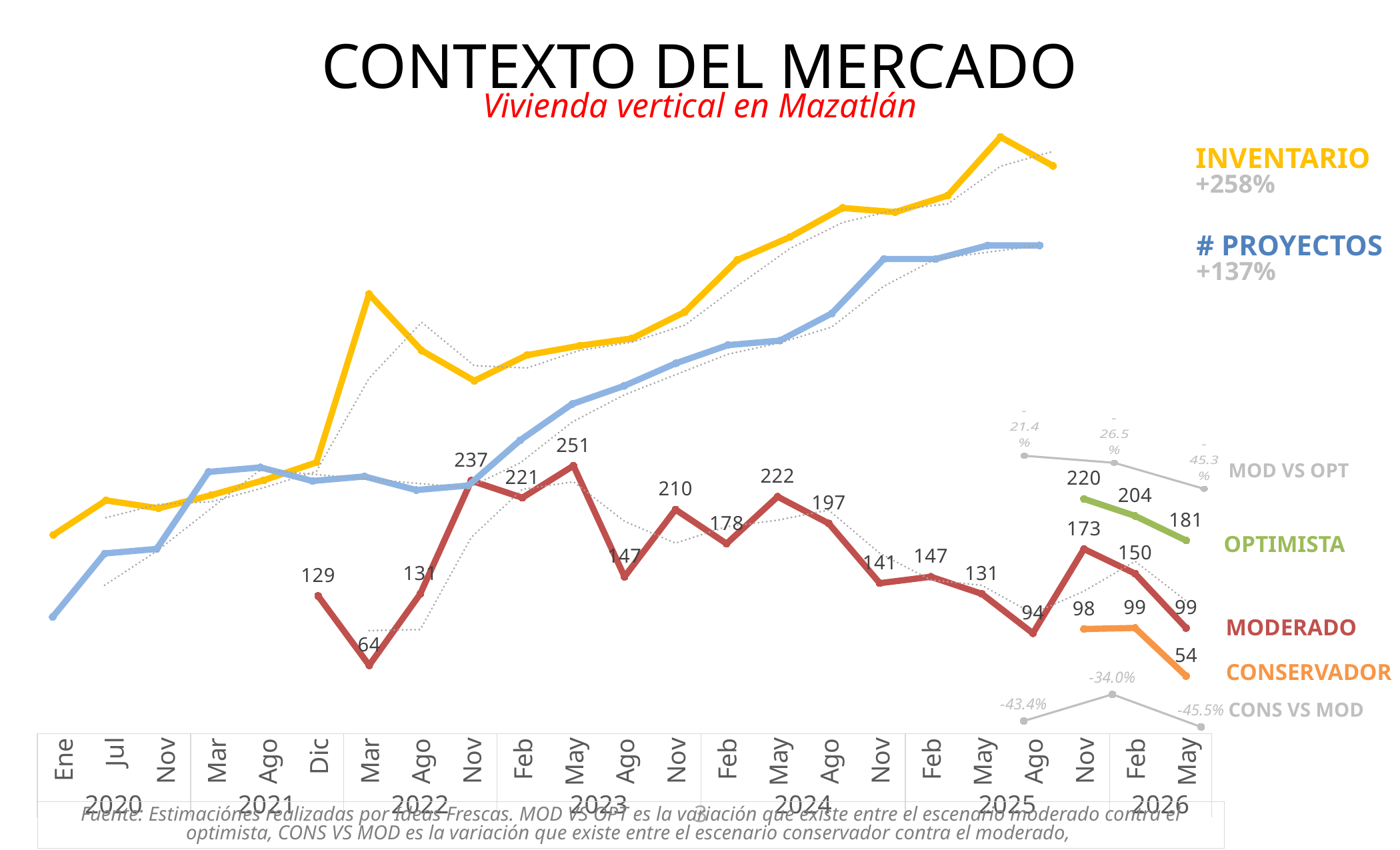
What is the difference between the OPTIMISTA and MODERADO values for May 2026? 82 In which month does the MODERADO series reach its highest labelled value? May 2023 In which month does the MODERADO series reach its lowest labelled value? Mar 2022 What is the MODERADO value for Mar 2022? 64 Which is larger for Feb 2026: the OPTIMISTA value or the CONSERVADOR value? OPTIMISTA What is the OPTIMISTA value for Nov 2025? 220 What percentage change is shown next to the INVENTARIO label? +258% What is the MODERADO value for May 2023? 251 Does the CONSERVADOR series rise or fall from Feb 2026 to May 2026? fall What kind of chart is shown on the slide? line chart What is the CONS VS MOD value for Feb 2026? -34.0% What is the CONSERVADOR value for May 2026? 54